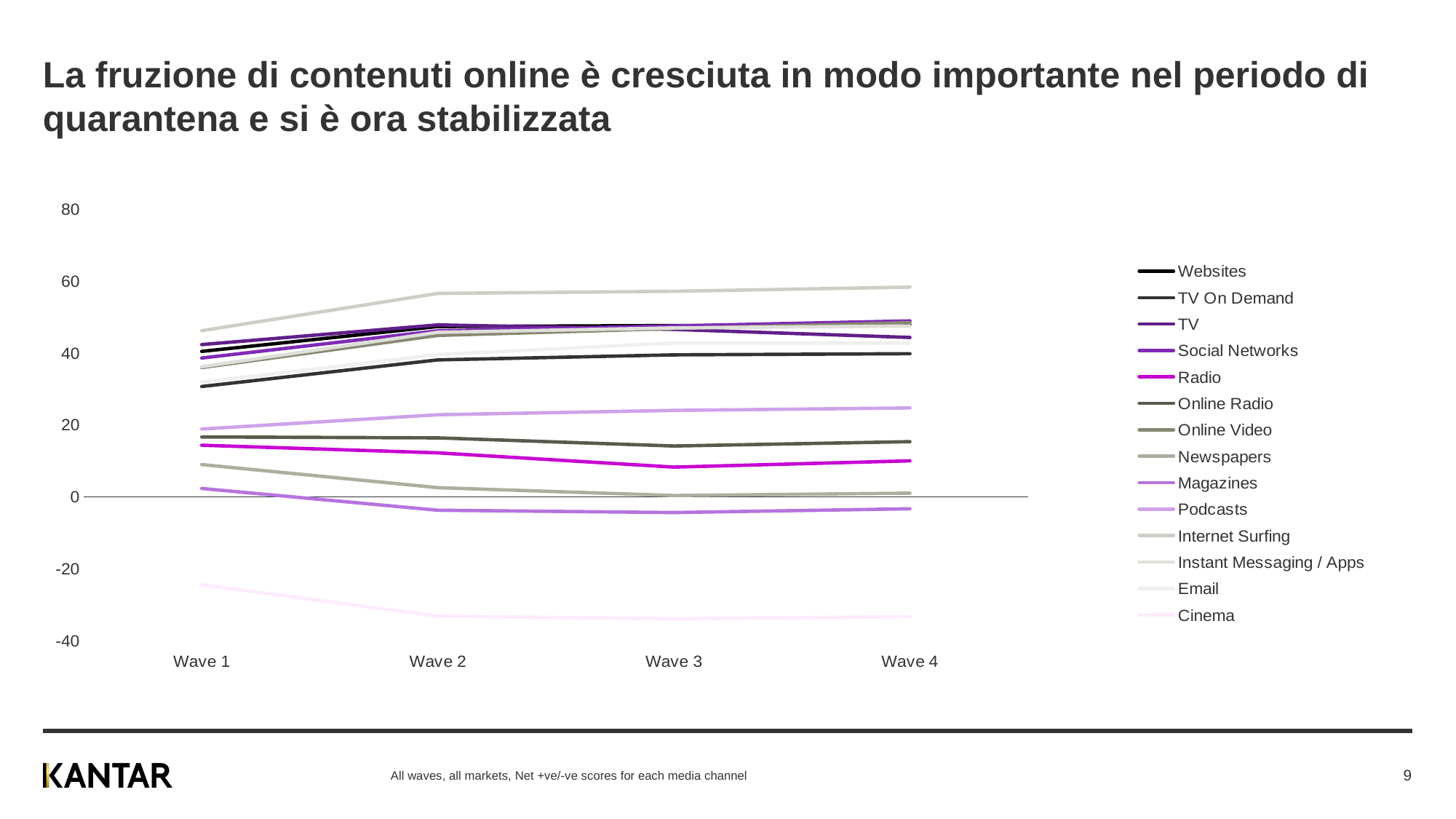
How many waves are shown on the x axis? 4 Is the value for Instant Messaging / Apps at Wave 4 greater or less than 40? greater What is the label of the first series in the legend? Websites Is the value for Podcasts at Wave 4 greater or less than 20? greater Does the Cinema line rise or fall from Wave 1 to Wave 2? fall What kind of chart is shown on the slide? line chart Which is larger at Wave 4, Podcasts or Radio? Podcasts How many series does the legend list? 14 Which series has the highest value at Wave 4? Internet Surfing Is the value for Cinema at Wave 1 greater or less than -20? less Which series has the lowest value at Wave 4? Cinema